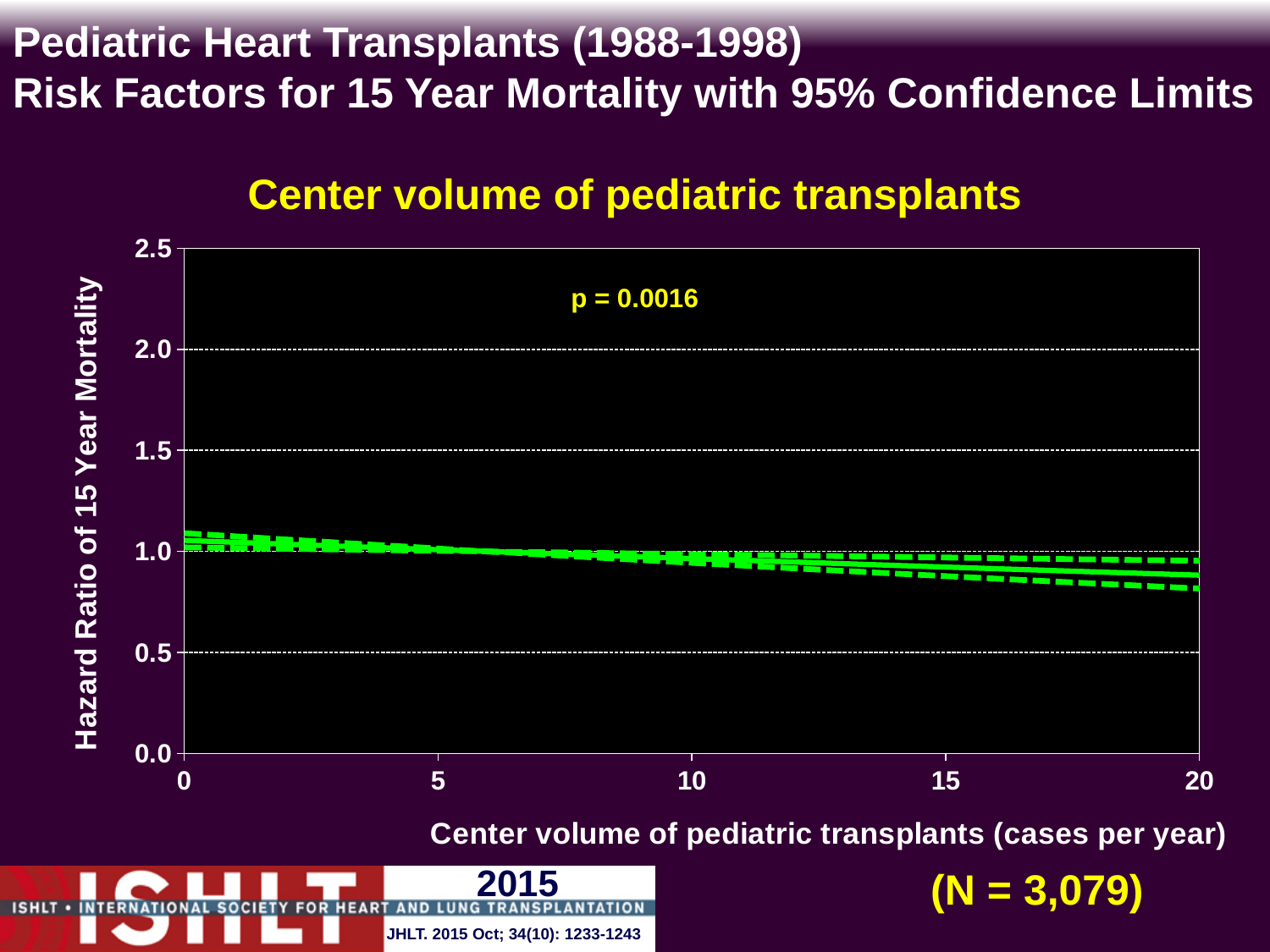
What is the label of the x axis? Center volume of pediatric transplants (cases per year) What p-value is printed on the chart? p = 0.0016 Is the hazard ratio at a center volume of 0 cases per year greater or less than 1.5? less Does the hazard ratio rise or fall as center volume increases along the x axis? fall Is the hazard ratio at a center volume of 20 cases per year greater or less than 1.0? less Is the hazard ratio at a center volume of 10 cases per year greater or less than 2.0? less What is the label of the y axis? Hazard Ratio of 15 Year Mortality What is the title of the chart? Center volume of pediatric transplants What colour are the plotted lines? green What is the maximum value shown on the y axis? 2.5 What kind of chart is shown on the slide? line chart What sample size (N) is printed on the slide? N = 3,079